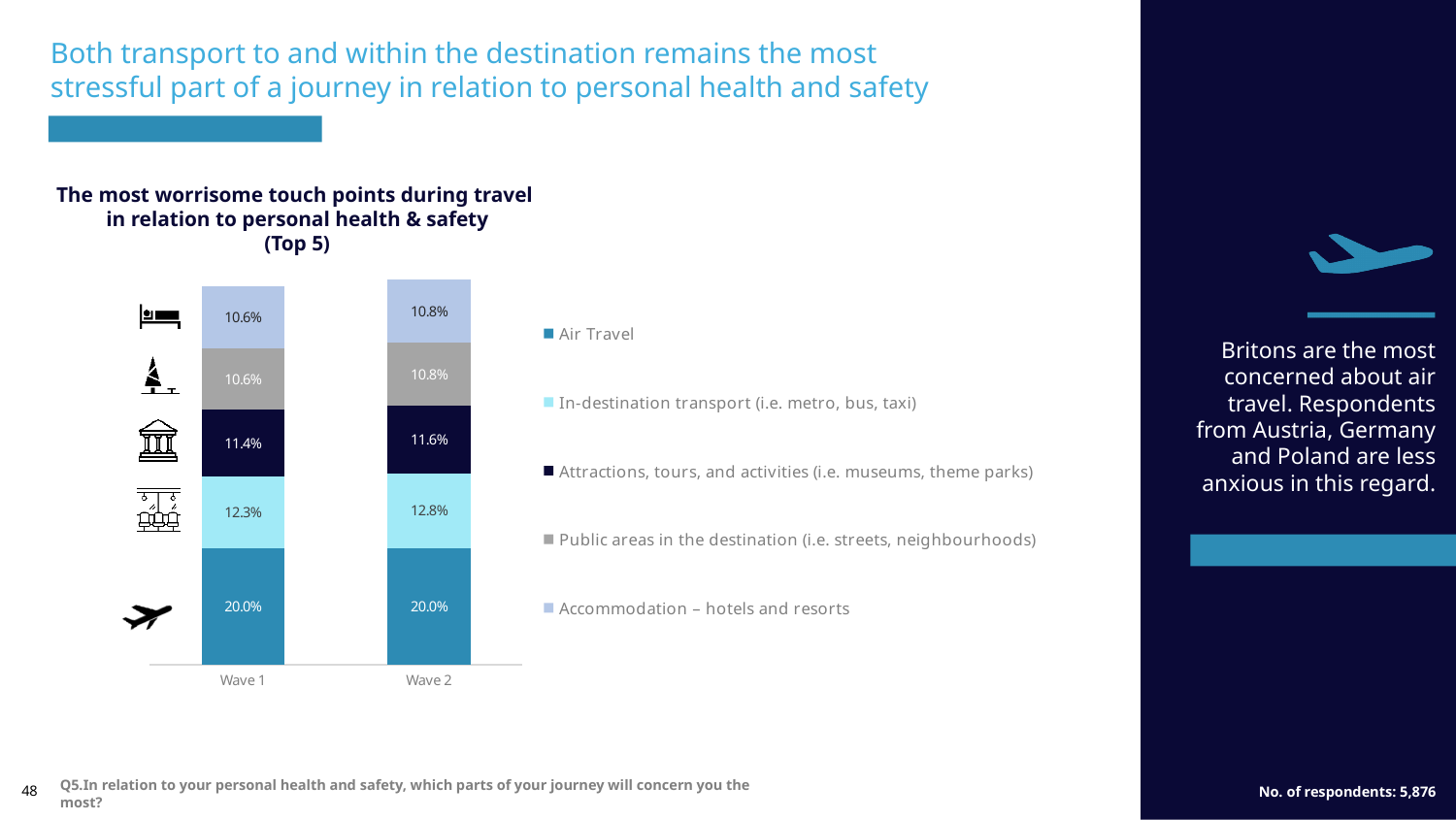
What is the difference between the In-destination transport values in Wave 2 and Wave 1? 0.5% Which touch point has the highest value in Wave 2? Air Travel How many series does the legend list? 5 What kind of chart is shown on the slide? Stacked bar chart Which is larger: Attractions, tours, and activities in Wave 2 or Public areas in the destination in Wave 2? Attractions, tours, and activities How many bars (waves) are shown on the x axis? 2 What is the value for Accommodation – hotels and resorts in Wave 2? 10.8% What is the title of the chart? The most worrisome touch points during travel in relation to personal health & safety (Top 5) What is the total of the Wave 1 stacked bar? 64.9% What is the value for Air Travel in Wave 1? 20.0% What is the value for Attractions, tours, and activities in Wave 1? 11.4% What is the value for In-destination transport in Wave 2? 12.8%